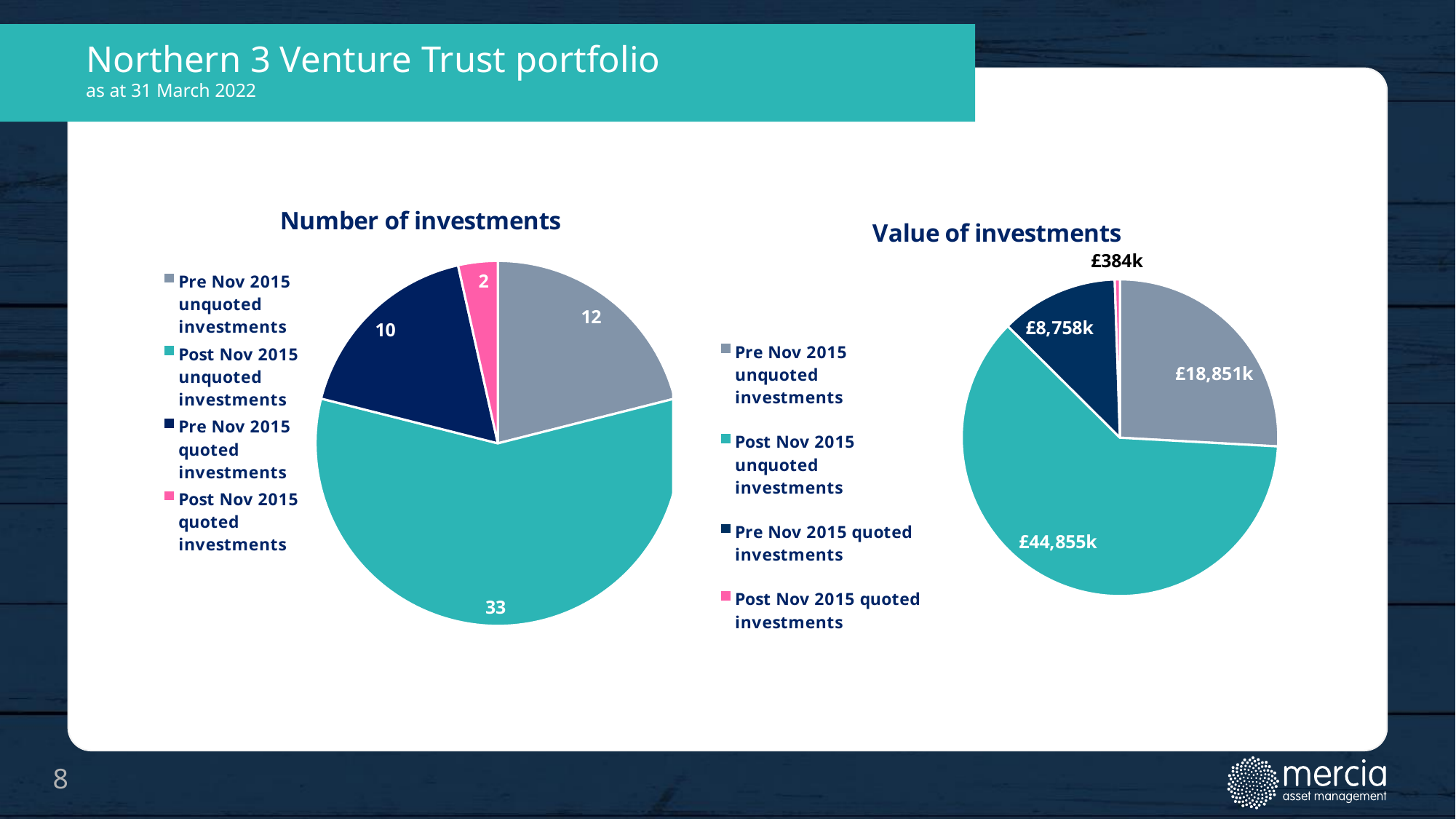
In the 'Value of investments' chart, how much larger is the Post Nov 2015 unquoted value than the Pre Nov 2015 unquoted value? £26,004k In the 'Number of investments' chart, how many Post Nov 2015 unquoted investments are there? 33 In the 'Value of investments' chart, which category has the largest value? Post Nov 2015 unquoted investments In the 'Value of investments' chart, which is larger: Pre Nov 2015 unquoted investments or Pre Nov 2015 quoted investments? Pre Nov 2015 unquoted investments In the 'Value of investments' chart, what is the value of Pre Nov 2015 unquoted investments? £18,851k In the 'Number of investments' chart, which category has the smallest number? Post Nov 2015 quoted investments What type of chart is the 'Value of investments' chart? Pie chart In the 'Number of investments' chart, what is the difference between Post Nov 2015 unquoted and Pre Nov 2015 unquoted investments? 21 In the 'Value of investments' chart, what is the value of Post Nov 2015 quoted investments? £384k In the 'Number of investments' chart, what is the value for Pre Nov 2015 quoted investments? 10 In the 'Number of investments' chart, what is the total number of investments across all categories? 57 How many categories does the 'Number of investments' chart show? 4